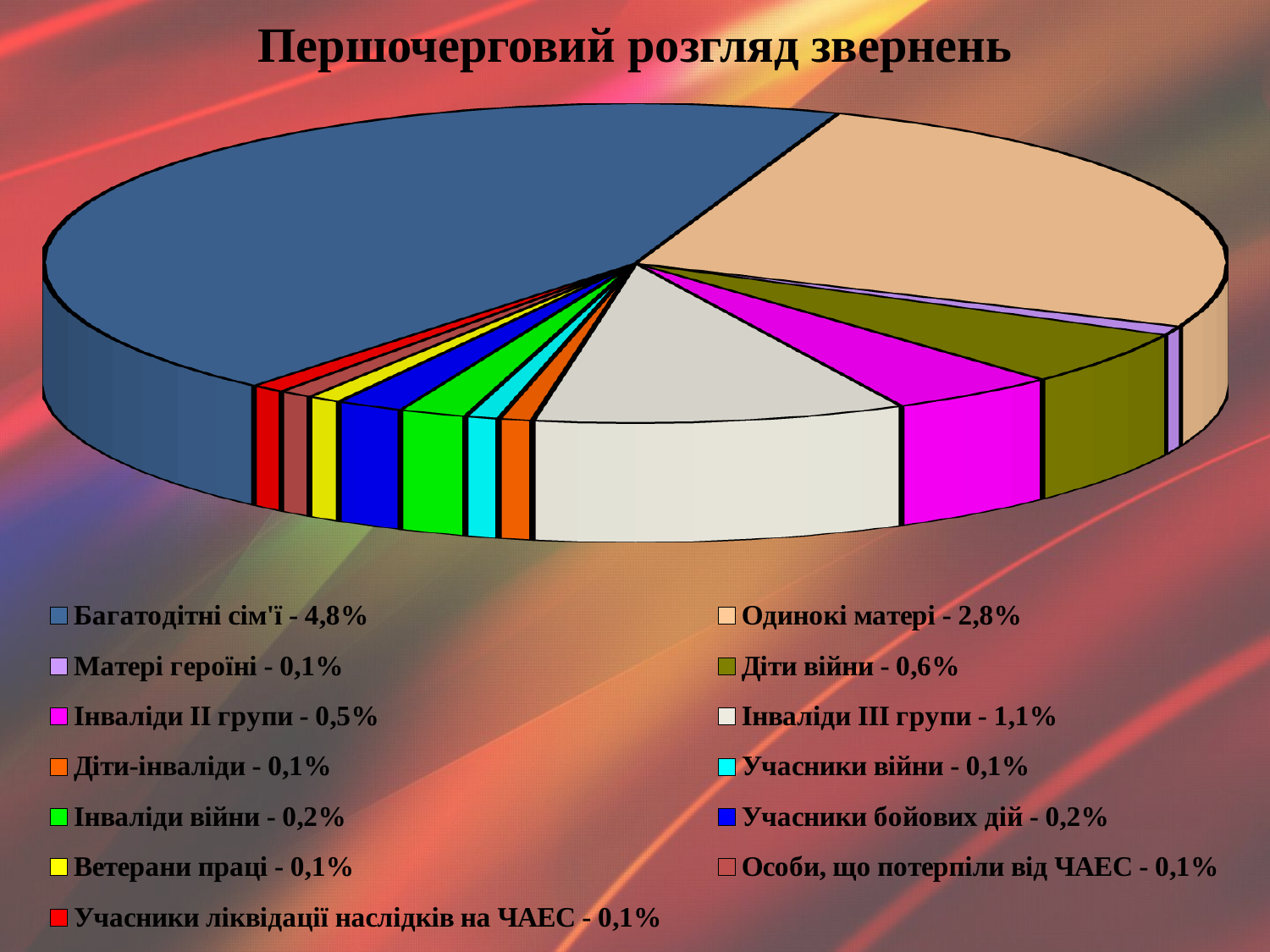
What is the title of the chart? Першочерговий розгляд звернень What is the value for Діти війни? 0,6% Which category has the highest value? Багатодітні сім'ї What is the value for Інваліди ІІІ групи? 1,1% What is the value for Одинокі матері? 2,8% What type of chart is shown on the slide? pie chart Which is larger, the value for Діти війни or the value for Інваліди ІІ групи? Діти війни What is the difference between the values for Багатодітні сім'ї and Одинокі матері? 2,0% What is the value for Багатодітні сім'ї? 4,8% What is the difference between the values for Інваліди ІІІ групи and Інваліди ІІ групи? 0,6% What colour is the slice for Інваліди ІІ групи? magenta How many categories does the pie chart have? 13